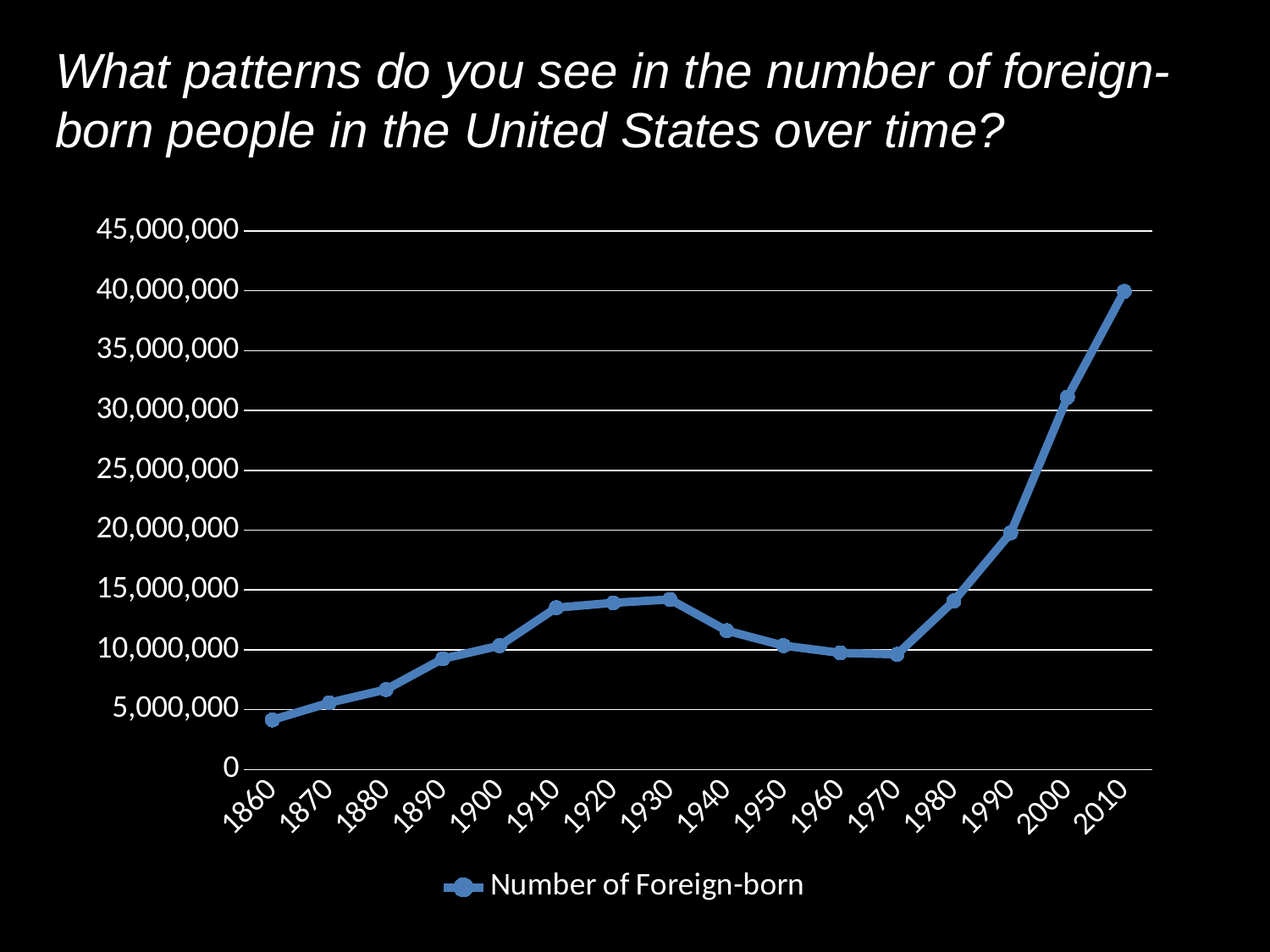
Which year has the highest number of foreign-born people? 2010 What is the name of the series shown in the legend? Number of Foreign-born How many data points are plotted on the chart? 16 Do the values rise or fall between 1970 and 2010? rise Is the value for 2000 greater or less than 25,000,000? greater What kind of chart is shown on the slide? line chart Is the value for 1860 greater or less than 5,000,000? less Is the value for 2010 greater or less than 35,000,000? greater How many series does the legend list? 1 Which year has a larger value, 1930 or 1960? 1930 Which year has the lowest number of foreign-born people? 1860